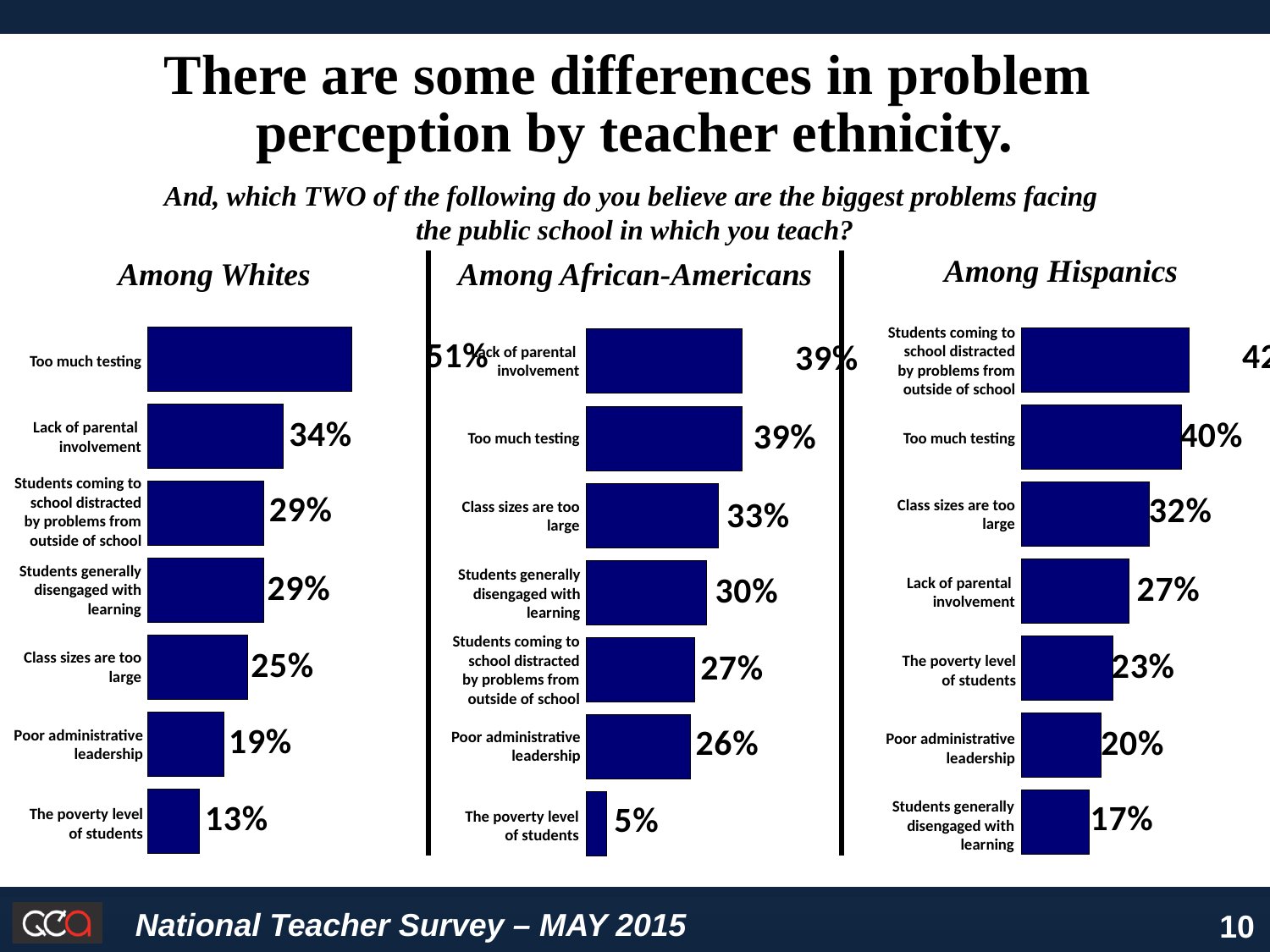
In the Among Whites chart, what is the value for Poor administrative leadership? 19% In the Among Hispanics chart, which is larger: Class sizes are too large or Lack of parental involvement? Class sizes are too large In the Among Hispanics chart, which problem has the lowest percentage? Students generally disengaged with learning In the Among Hispanics chart, what is the value for Too much testing? 40% In the Among Whites chart, which problem has the lowest percentage? The poverty level of students In the Among Whites chart, what is the difference between Lack of parental involvement and Class sizes are too large? 9% How many problem categories are shown in the Among Whites chart? 7 In the Among African-Americans chart, which problem has the lowest percentage? The poverty level of students In the Among Whites chart, what percentage of teachers chose Too much testing? 51% In the Among African-Americans chart, what is the value for Class sizes are too large? 33% What type of chart is the Among Hispanics chart? Bar chart In the Among African-Americans chart, what is the difference between Students generally disengaged with learning and The poverty level of students? 25%